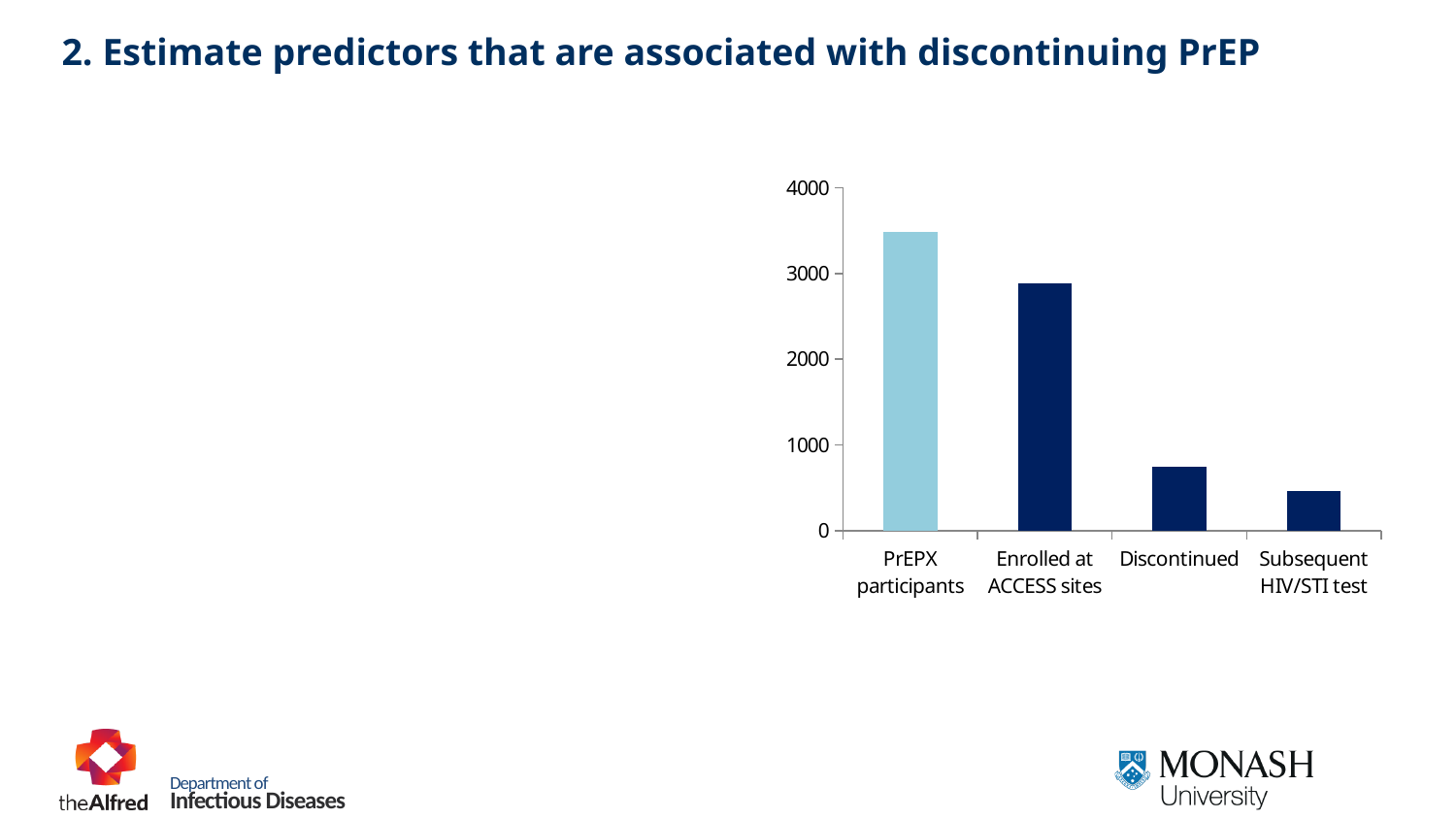
Is the value for Enrolled at ACCESS sites greater or less than 2000? greater Which category has the lowest bar in the chart? Subsequent HIV/STI test Is the value for Discontinued greater or less than 1000? less What kind of chart is shown on the slide? bar chart Is the value for Subsequent HIV/STI test greater or less than 1000? less Which bar in the chart is coloured light blue rather than dark navy? PrEPX participants How many categories are shown on the x axis of the chart? 4 Which is larger, the value for PrEPX participants or the value for Enrolled at ACCESS sites? PrEPX participants Do the bar values rise or fall from left to right across the x axis? fall Which is larger, the value for Discontinued or the value for Subsequent HIV/STI test? Discontinued Which category has the highest bar in the chart? PrEPX participants